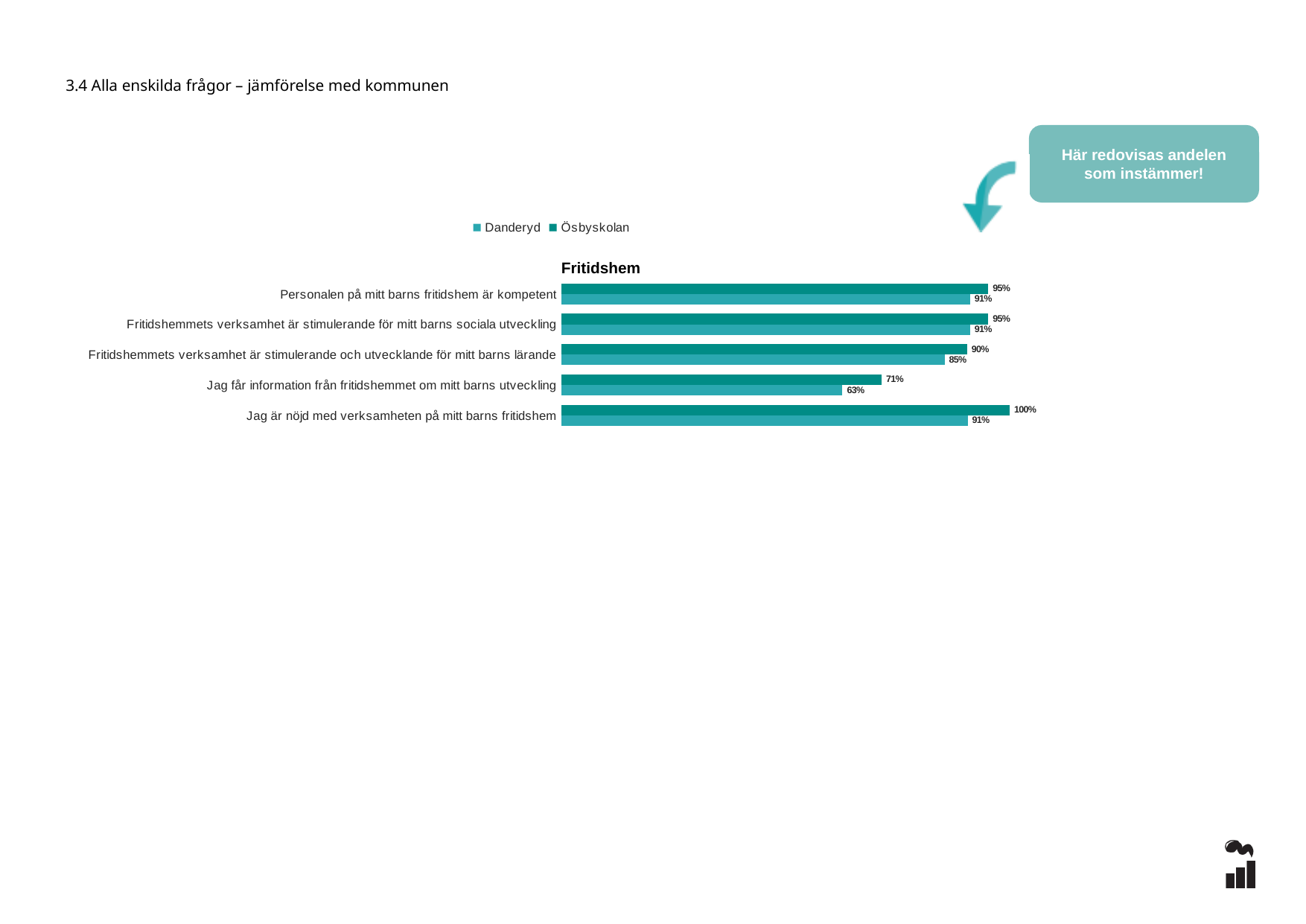
What is the value for Danderyd for 'Jag får information från fritidshemmet om mitt barns utveckling'? 63% How many series does the legend list? 2 What is the difference between Ösbyskolan and Danderyd for 'Jag är nöjd med verksamheten på mitt barns fritidshem'? 9% What type of chart is shown on the slide? bar chart What is the title of the chart? Fritidshem What is the value for Ösbyskolan for 'Fritidshemmets verksamhet är stimulerande och utvecklande för mitt barns lärande'? 90% Which category has the lowest value for Ösbyskolan? Jag får information från fritidshemmet om mitt barns utveckling What is the value for Ösbyskolan for 'Jag är nöjd med verksamheten på mitt barns fritidshem'? 100% What is the difference between Ösbyskolan and Danderyd for 'Jag får information från fritidshemmet om mitt barns utveckling'? 8% For 'Personalen på mitt barns fritidshem är kompetent', which is larger, Ösbyskolan or Danderyd? Ösbyskolan Which category has the highest value for Ösbyskolan? Jag är nöjd med verksamheten på mitt barns fritidshem How many categories (questions) are shown in the chart? 5